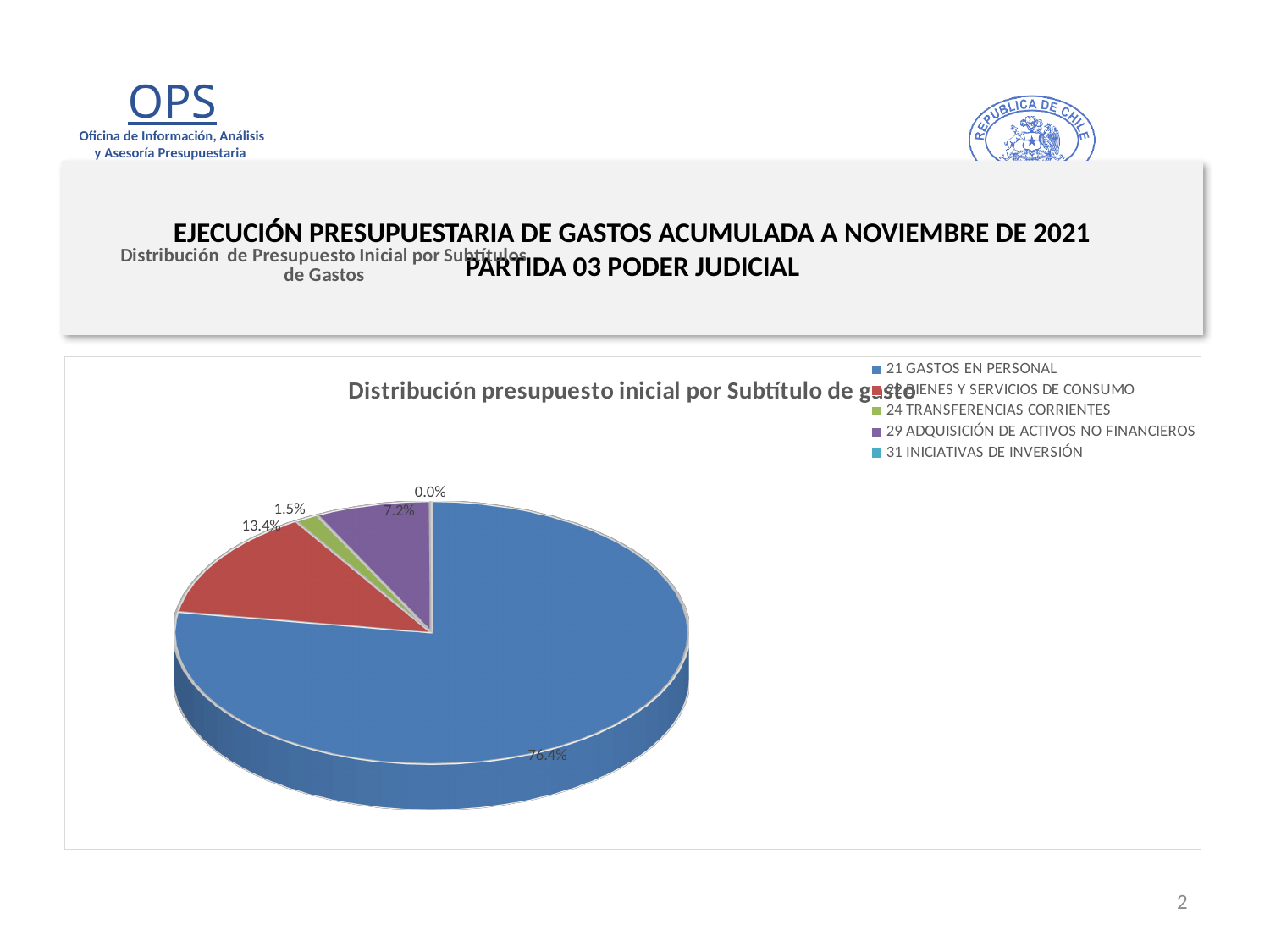
How many categories does the legend of the pie chart list? 5 What percentage is shown for 31 INICIATIVAS DE INVERSIÓN? 0.0% What percentage is shown for BIENES Y SERVICIOS DE CONSUMO? 13.4% What kind of chart is shown on the slide? Pie chart What share of the pie does 21 GASTOS EN PERSONAL represent? 76.4% What is the difference in percentage points between 21 GASTOS EN PERSONAL and BIENES Y SERVICIOS DE CONSUMO? 63.0 percentage points Which category has the largest slice of the pie? 21 GASTOS EN PERSONAL Which is larger, the slice for 29 ADQUISICIÓN DE ACTIVOS NO FINANCIEROS or the slice for 24 TRANSFERENCIAS CORRIENTES? 29 ADQUISICIÓN DE ACTIVOS NO FINANCIEROS What colour is the slice for 21 GASTOS EN PERSONAL? Blue Which category has the smallest slice of the pie? 31 INICIATIVAS DE INVERSIÓN What percentage is shown for 29 ADQUISICIÓN DE ACTIVOS NO FINANCIEROS? 7.2% What percentage is shown for 24 TRANSFERENCIAS CORRIENTES? 1.5%